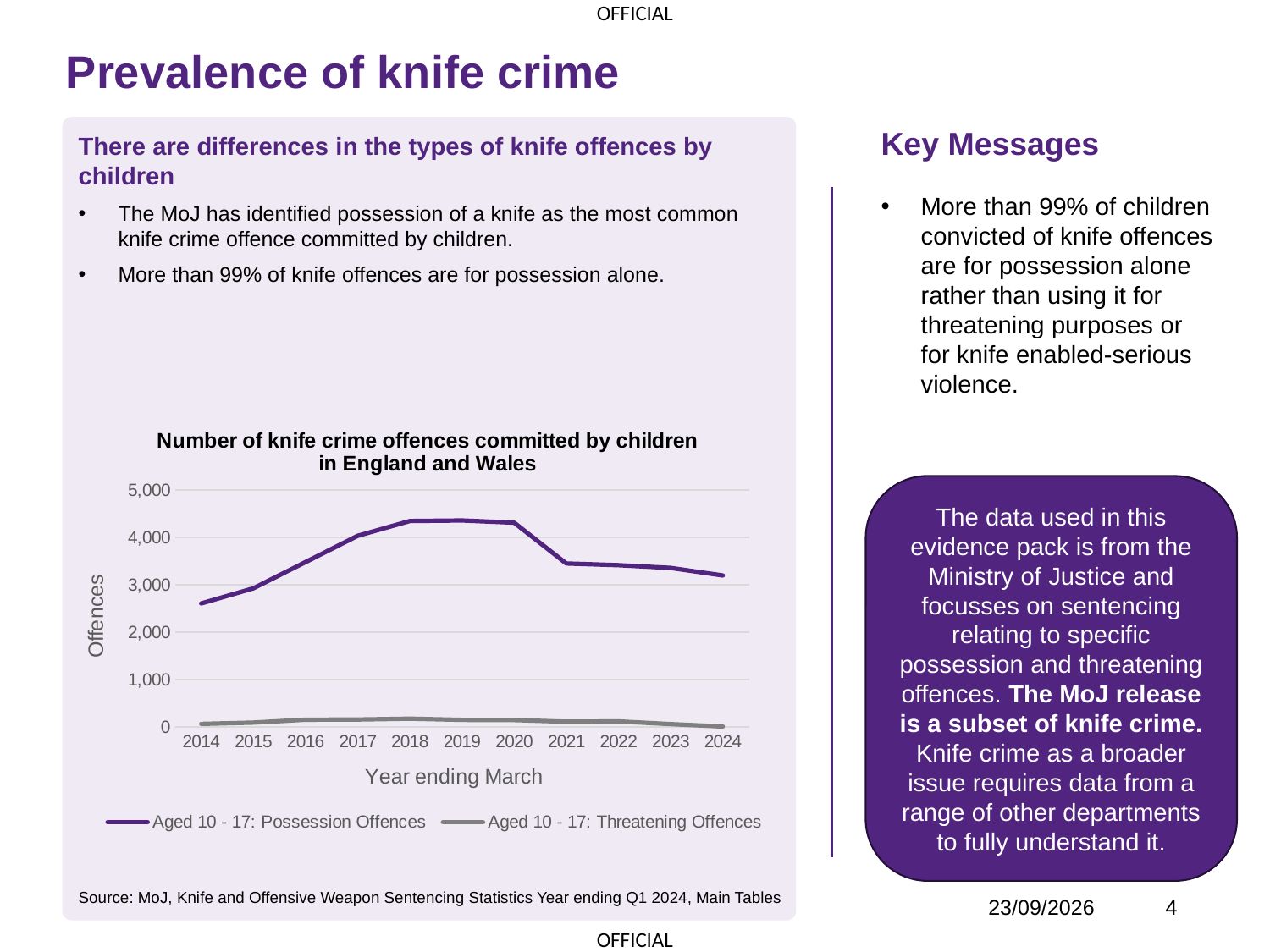
What is the label on the x axis of the chart? Year ending March How many series does the chart legend list? 2 Is the value for Aged 10 - 17: Possession Offences in 2024 greater or less than 3,000? greater Do the Aged 10 - 17: Possession Offences values rise or fall between 2020 and 2024? fall Which series has the larger value in 2020, Possession Offences or Threatening Offences? Aged 10 - 17: Possession Offences Is the value for Aged 10 - 17: Threatening Offences in 2019 greater or less than 1,000? less How many years are plotted along the x axis of the chart? 11 Is the value for Aged 10 - 17: Possession Offences in 2014 greater or less than 3,000? less In which year is the Aged 10 - 17: Possession Offences series at its lowest? 2014 What kind of chart is shown on the slide? Line chart Do the Aged 10 - 17: Possession Offences values rise or fall between 2014 and 2018? rise